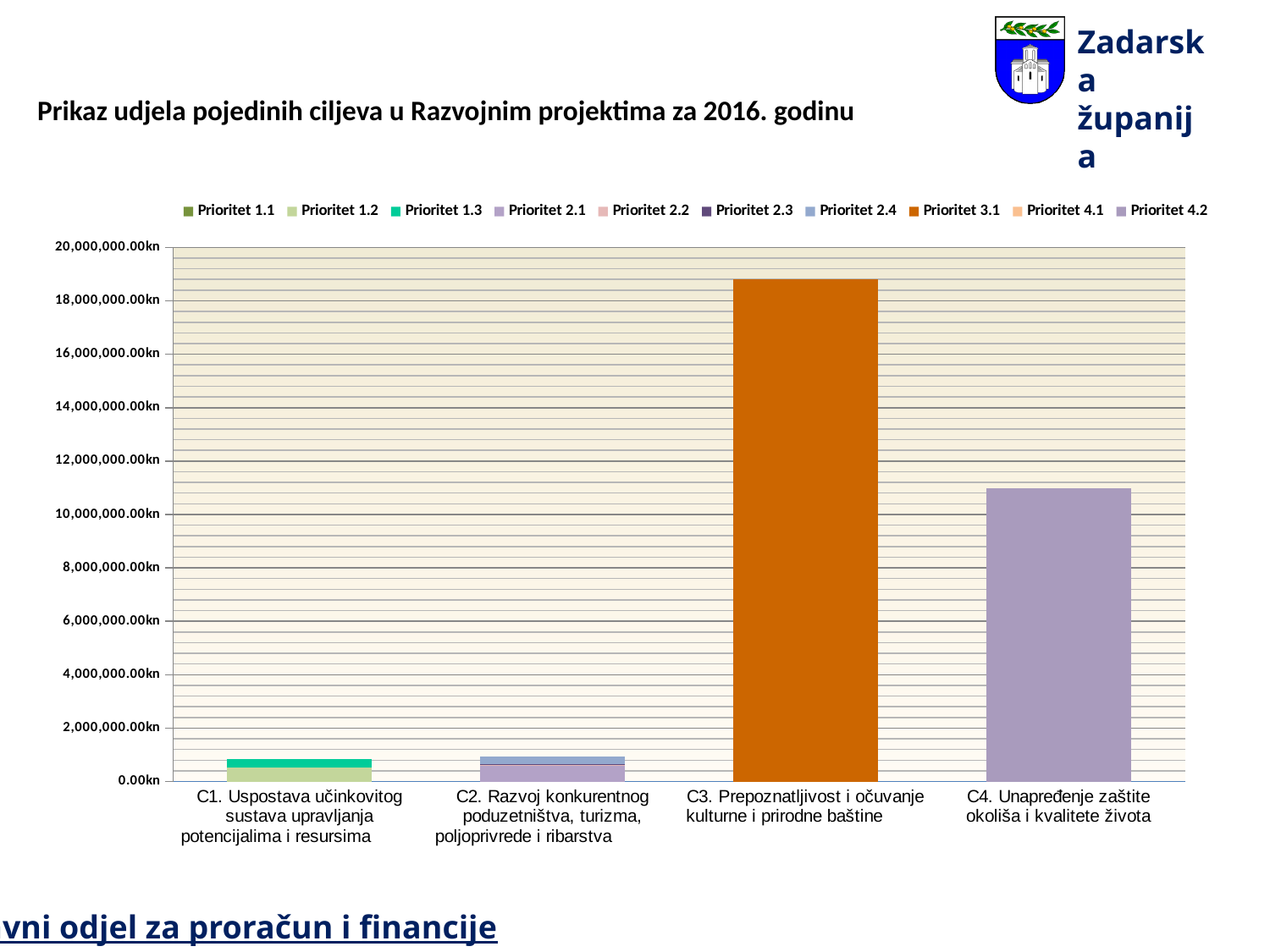
Which has the larger total bar, C3. Prepoznatljivost i očuvanje kulturne i prirodne baštine or C4. Unapređenje zaštite okoliša i kvalitete života? C3. Prepoznatljivost i očuvanje kulturne i prirodne baštine Is the total value for C4. Unapređenje zaštite okoliša i kvalitete života greater or less than 10,000,000.00kn? greater What kind of chart is shown on the slide? bar chart Is the total value for C4. Unapređenje zaštite okoliša i kvalitete života greater or less than 12,000,000.00kn? less Which legend entry is listed first in the chart's legend? Prioritet 1.1 How many series does the chart's legend list? 10 Is the total value for C3. Prepoznatljivost i očuvanje kulturne i prirodne baštine greater or less than 18,000,000.00kn? greater How many categories are shown on the x axis of the chart? 4 Which has the larger total bar, C4. Unapređenje zaštite okoliša i kvalitete života or C2. Razvoj konkurentnog poduzetništva, turizma, poljoprivrede i ribarstva? C4. Unapređenje zaštite okoliša i kvalitete života Which category has the highest total bar? C3. Prepoznatljivost i očuvanje kulturne i prirodne baštine What is the title of the chart on the slide? Prikaz udjela pojedinih ciljeva u Razvojnim projektima za 2016. godinu